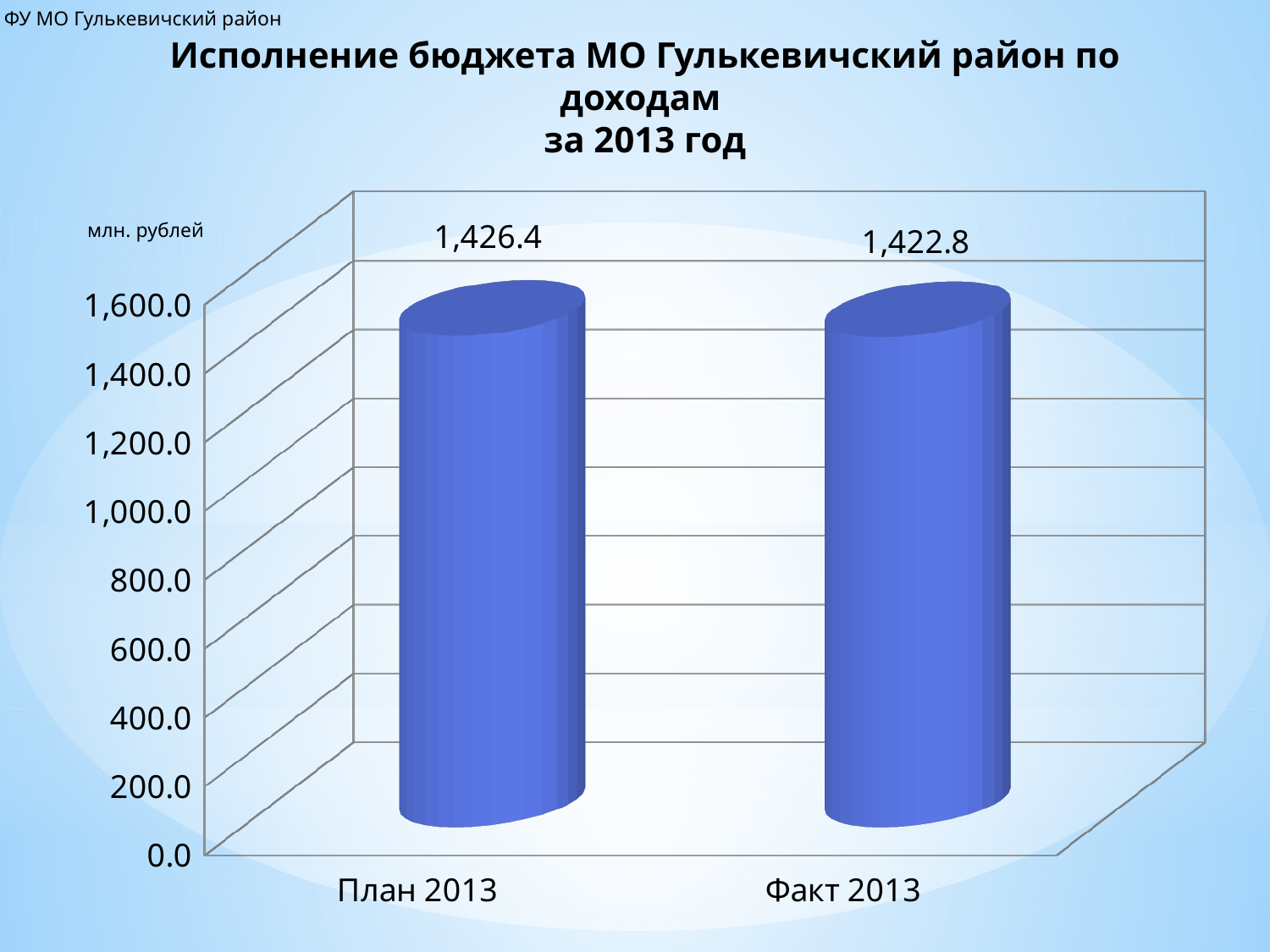
Which category has the lowest value? Факт 2013 How many categories are shown on the x axis? 2 What kind of chart is shown on the slide? bar chart Is the value for План 2013 greater or less than 1,600.0? less What is the value for План 2013? 1,426.4 What is the value for Факт 2013? 1,422.8 Do the values rise or fall from План 2013 to Факт 2013? fall Is the value for Факт 2013 greater or less than 1,200.0? greater What unit of measurement is indicated for the chart values? млн. рублей What is the title of the chart? Исполнение бюджета МО Гулькевичский район по доходам за 2013 год Which category has the higher value, План 2013 or Факт 2013? План 2013 What is the difference between the values for План 2013 and Факт 2013? 3.6